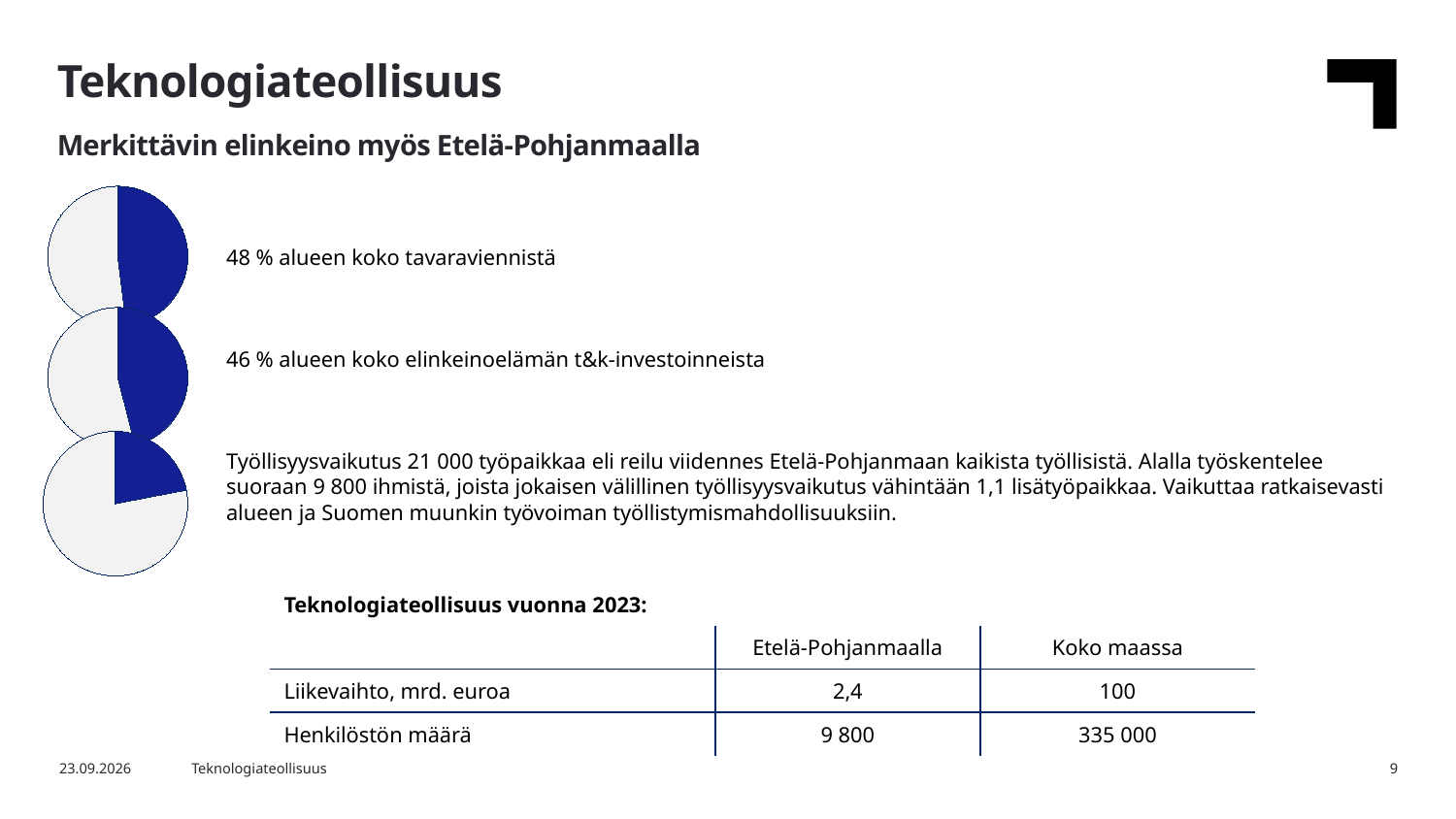
What colour is the highlighted slice in the pie charts? Blue Is the highlighted slice larger in the top pie chart or in the bottom pie chart? Top What kind of charts are shown on the left side of the slide? Pie charts Which of the three pie charts has the smallest highlighted slice? The bottom one (työllisyysvaikutus) What does the top pie chart's highlighted slice describe, according to the text next to it? 48 % alueen koko tavaraviennistä In the middle pie chart, what share of the region's business R&D investments does the highlighted slice represent? 46 % Is the highlighted share in the bottom pie chart greater or less than 50 %? Less Is the highlighted share in the top pie chart greater or less than 50 %? Less How many pie charts are on the slide? 3 In the top pie chart, what share of the region's total goods exports does the highlighted slice represent? 48 %